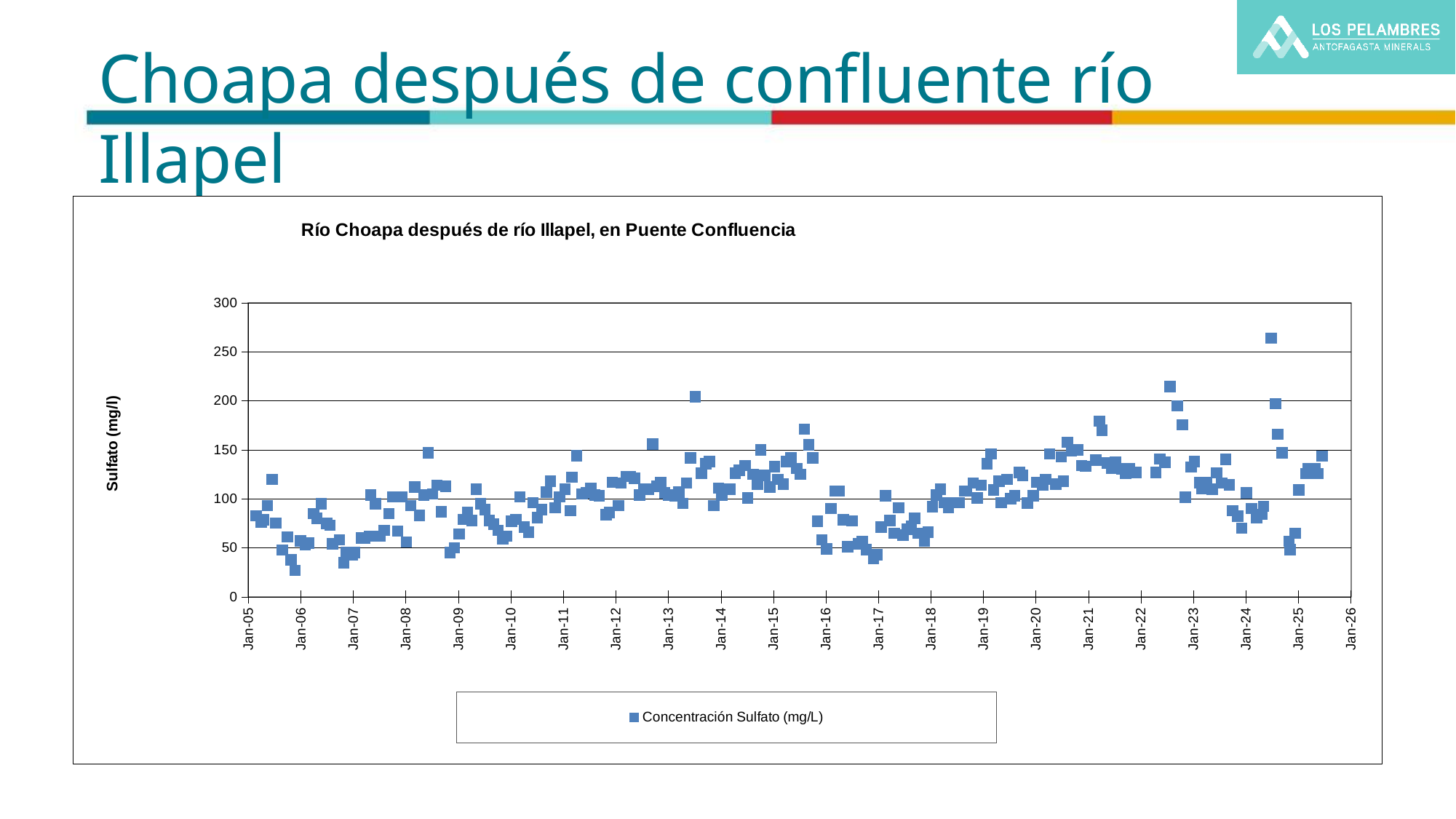
How many series does the legend list? 1 How many date labels are shown on the horizontal axis? 22 What is the last date label on the horizontal axis? Jan-26 What is the name of the series shown in the legend? Concentración Sulfato (mg/L) What is the first date label on the horizontal axis? Jan-05 What kind of chart is shown on the slide? scatter chart Is the lowest plotted sulfate value, near Jan-06, greater or less than 50? less Is the highest plotted sulfate value greater or less than 250? greater What is the label of the vertical axis? Sulfato (mg/l) What is the title of the chart? Río Choapa después de río Illapel, en Puente Confluencia In which year does the highest plotted sulfate value occur? 2024 What is the maximum value shown on the vertical axis? 300